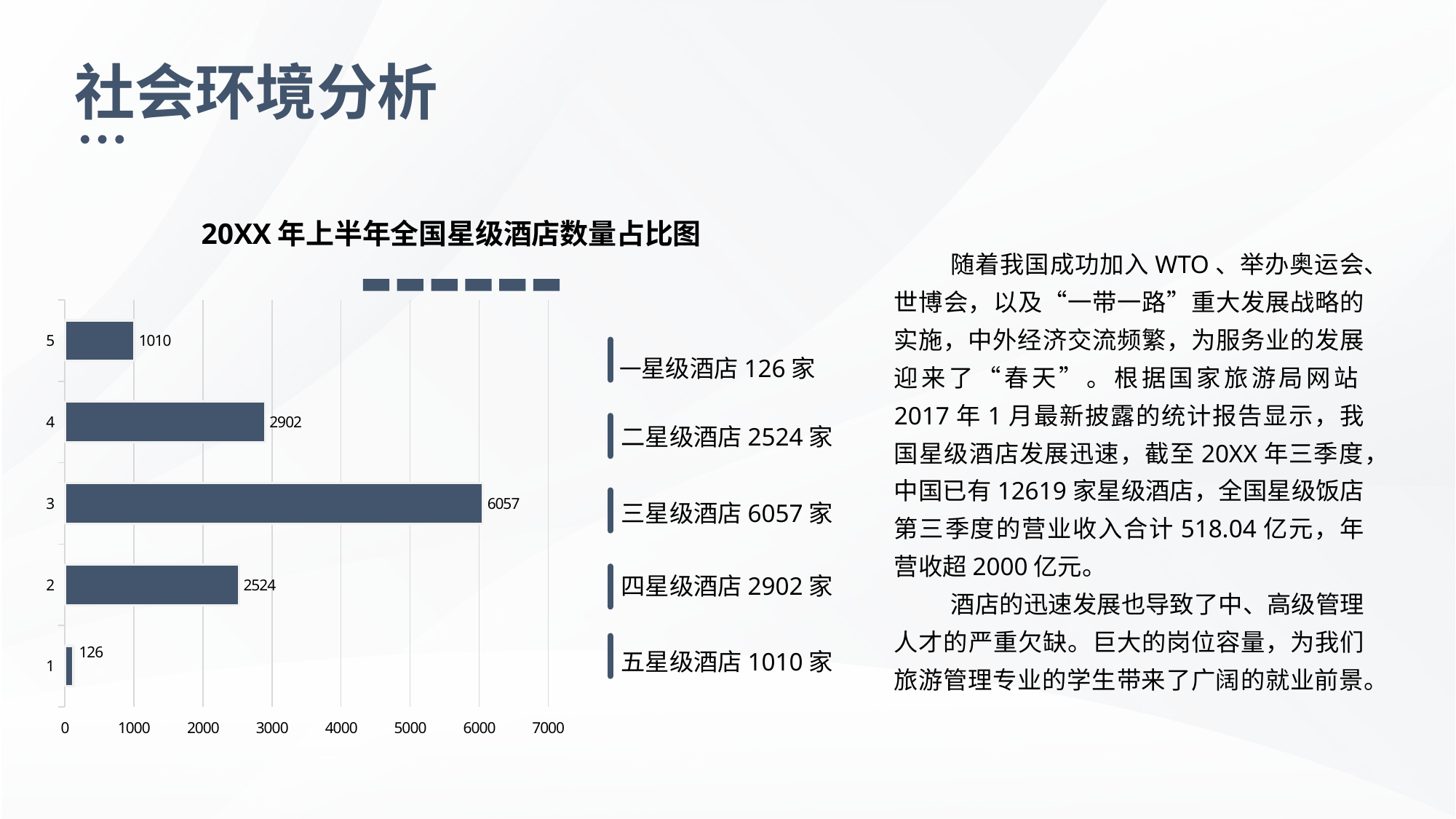
Which is larger, the value for category 4 or the value for category 2? category 4 What is the difference between the values for category 2 and category 5? 1514 What is the difference between the values for category 3 and category 4? 3155 What kind of chart is shown on the slide? bar chart What is the value for category 3? 6057 Which category has the lowest value? 1 How many categories are shown in the chart? 5 What is the value for category 5? 1010 What is the value for category 1? 126 What is the title of the chart? 20XX 年上半年全国星级酒店数量占比图 Which category has the highest value? 3 Is the value for category 4 greater or less than 3000? less